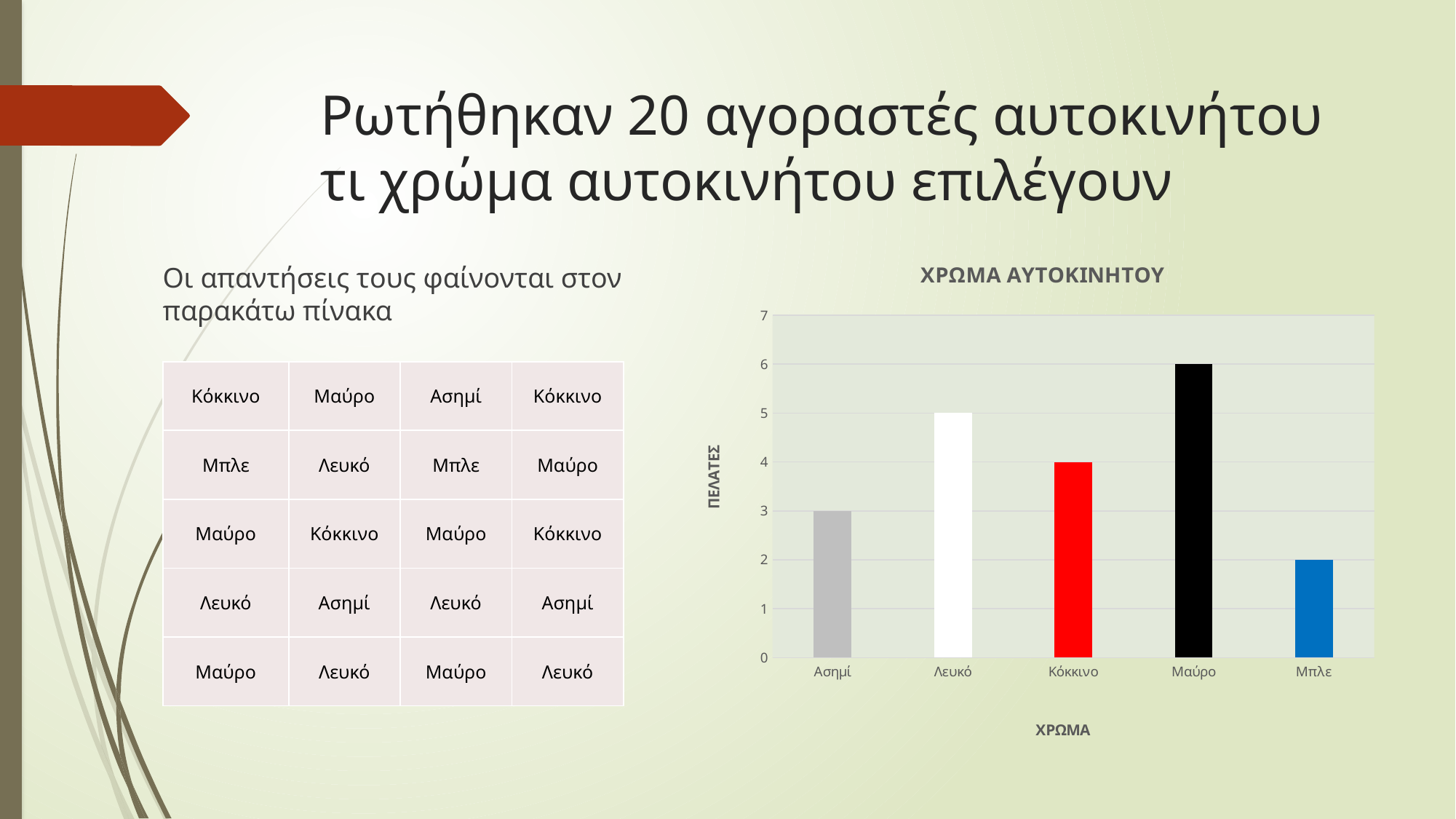
What is the label of the vertical axis of the chart? ΠΕΛΑΤΕΣ What is the difference between the number of customers for Μαύρο and Μπλε? 4 Which has more customers, Κόκκινο or Ασημί? Κόκκινο How many customers chose Ασημί according to the chart? 3 What is the title of the chart? ΧΡΩΜΑ ΑΥΤΟΚΙΝΗΤΟΥ Is the value for Λευκό greater or less than 4? greater How many colour categories are plotted in the chart? 5 How many customers chose Λευκό according to the chart? 5 How many customers chose Μαύρο according to the chart? 6 Which colour has the highest number of customers in the chart? Μαύρο Which colour has the lowest number of customers in the chart? Μπλε What kind of chart is shown on the slide? bar chart